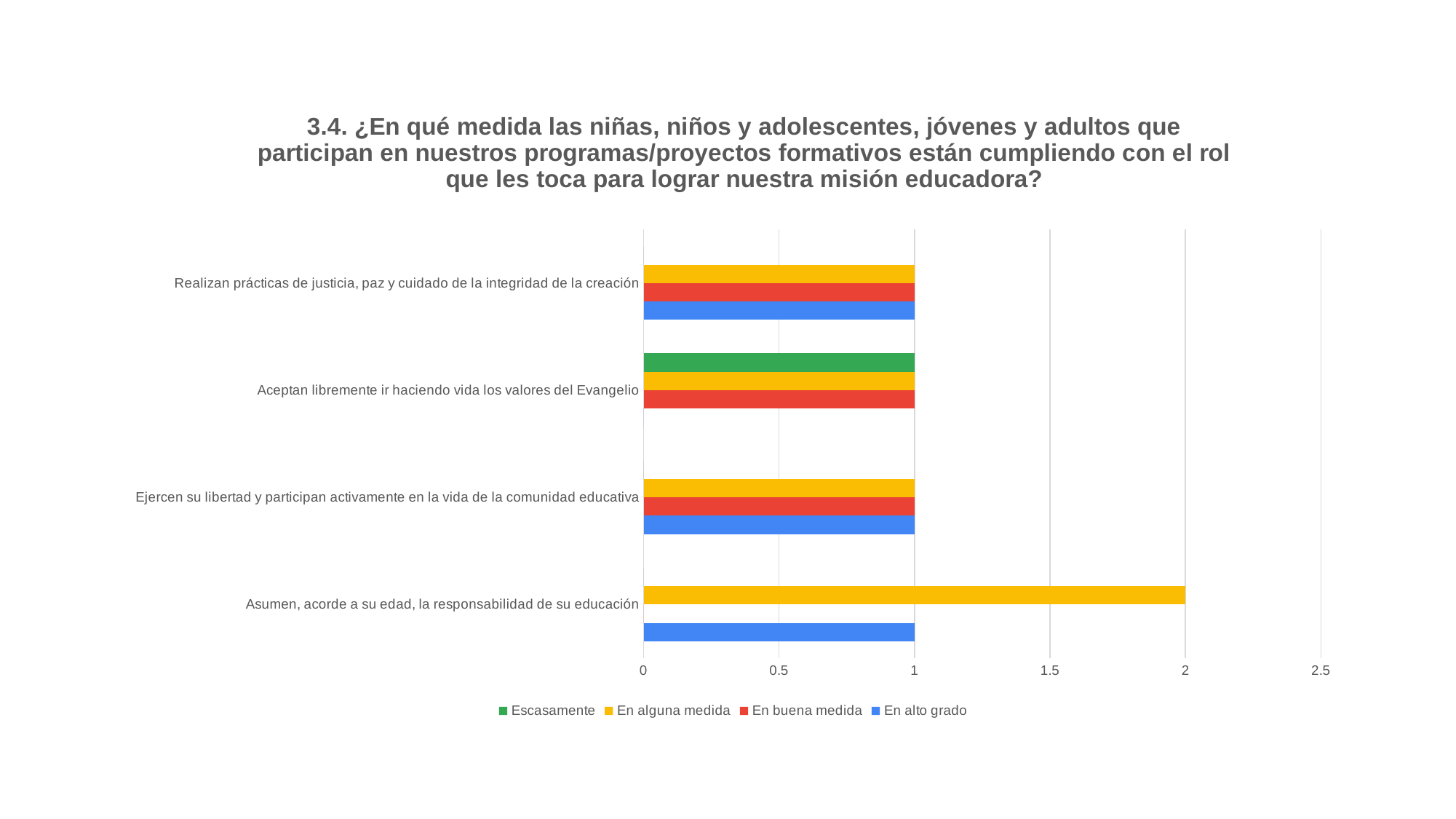
What colour represents "En alto grado" in the legend? blue How many categories are plotted on the chart? 4 What kind of chart is shown on the slide? bar chart What is the value of "En alto grado" for "Asumen, acorde a su edad, la responsabilidad de su educación"? 1 What is the difference between the "En alguna medida" and "En alto grado" values for "Asumen, acorde a su edad, la responsabilidad de su educación"? 1 How many series does the legend list? 4 Is the value of "En alguna medida" for "Asumen, acorde a su edad, la responsabilidad de su educación" greater or less than 1.5? greater What is the value of "Escasamente" for "Aceptan libremente ir haciendo vida los valores del Evangelio"? 1 Which category is the only one with a bar for "Escasamente"? Aceptan libremente ir haciendo vida los valores del Evangelio Which category has the highest value for "En alguna medida"? Asumen, acorde a su edad, la responsabilidad de su educación For "Asumen, acorde a su edad, la responsabilidad de su educación", which is larger: "En alguna medida" or "En alto grado"? En alguna medida What is the value of "En alguna medida" for "Asumen, acorde a su edad, la responsabilidad de su educación"? 2